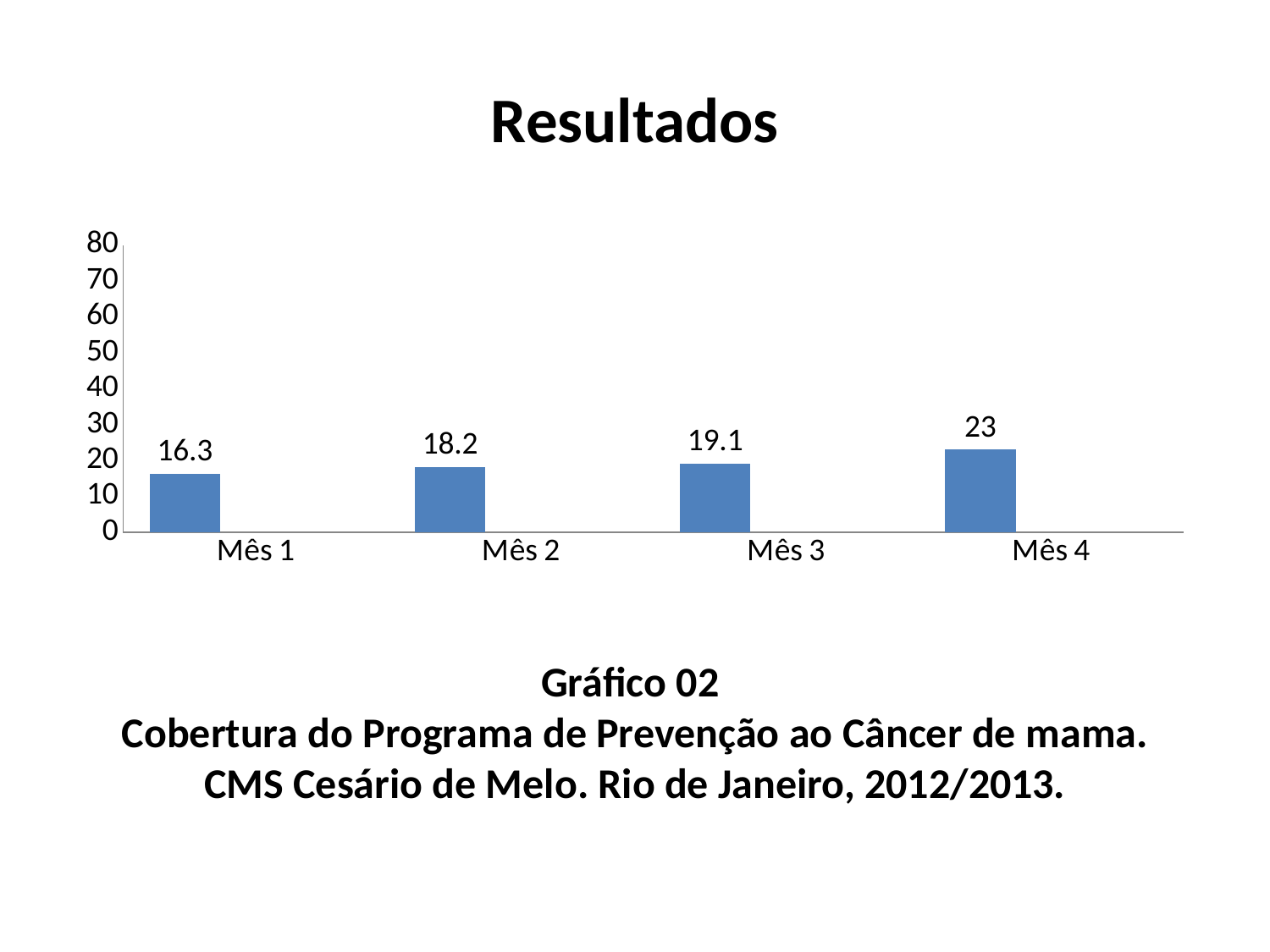
What is the value for Mês 4? 23 What is the difference between the values for Mês 2 and Mês 1? 1.9 What kind of chart is shown on the slide? bar chart Which is larger, the value for Mês 2 or the value for Mês 3? Mês 3 Is the value for Mês 4 greater or less than 30? less Which month has the lowest value? Mês 1 How many months are shown on the x axis? 4 What is the value for Mês 1? 16.3 What is the difference between the values for Mês 4 and Mês 1? 6.7 Which month has the highest value? Mês 4 What is the value for Mês 3? 19.1 Do the values rise or fall from Mês 1 to Mês 4? rise